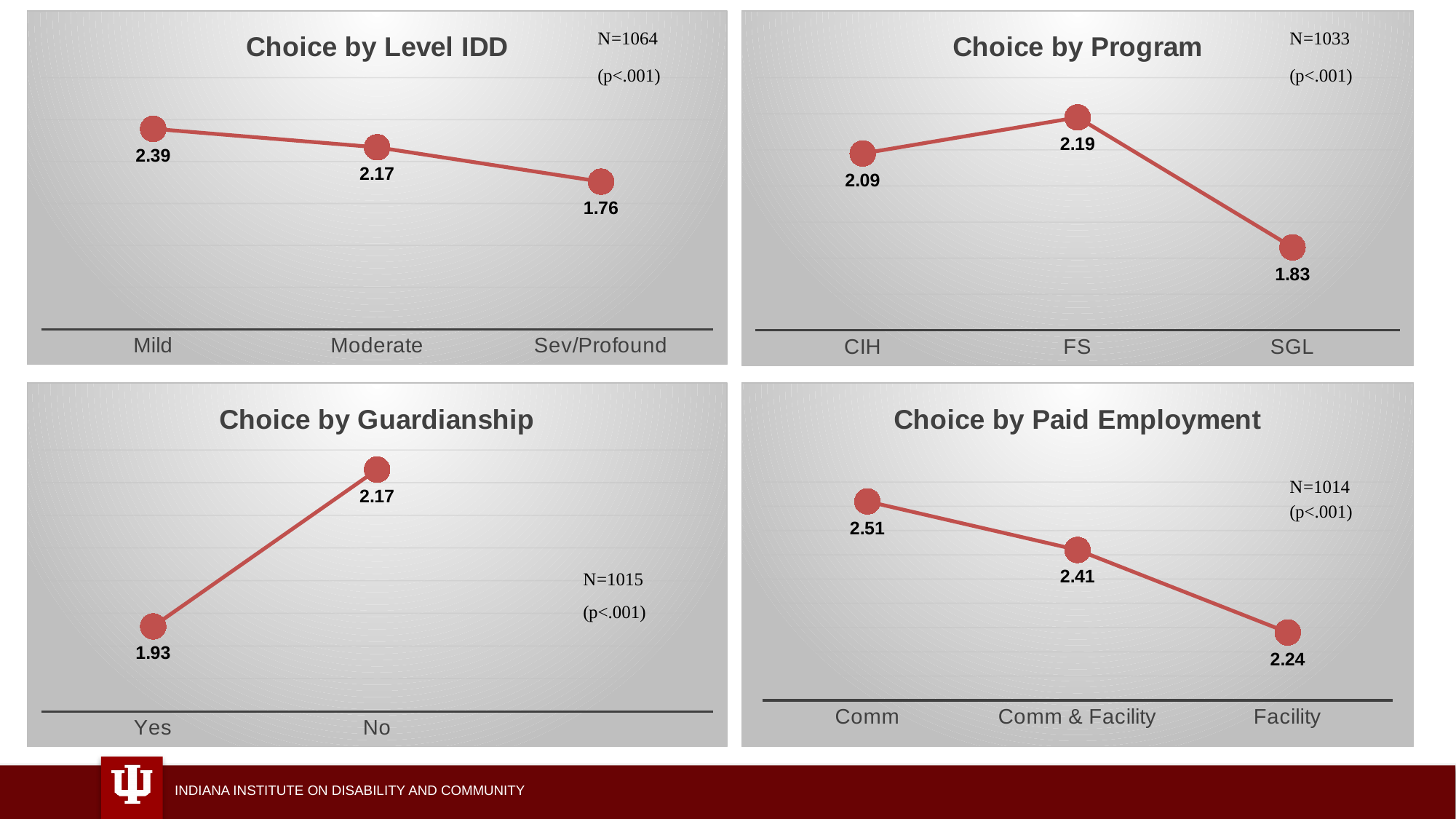
In the 'Choice by Level IDD' chart, what is the value for Moderate? 2.17 In the 'Choice by Program' chart, what is the value for CIH? 2.09 In the 'Choice by Paid Employment' chart, what is the value for Facility? 2.24 In the 'Choice by Program' chart, which category has the highest value? FS In the 'Choice by Paid Employment' chart, do the values rise or fall from Comm to Facility? fall In the 'Choice by Level IDD' chart, what is the difference between the values for Mild and Sev/Profound? 0.63 In the 'Choice by Paid Employment' chart, what is the difference between the values for Comm and Comm & Facility? 0.10 In the 'Choice by Guardianship' chart, what is the value for Yes? 1.93 What kind of chart is 'Choice by Level IDD'? line chart In the 'Choice by Program' chart, how many categories are plotted? 3 In the 'Choice by Guardianship' chart, which is larger, the value for Yes or the value for No? No In the 'Choice by Level IDD' chart, which category has the lowest value? Sev/Profound